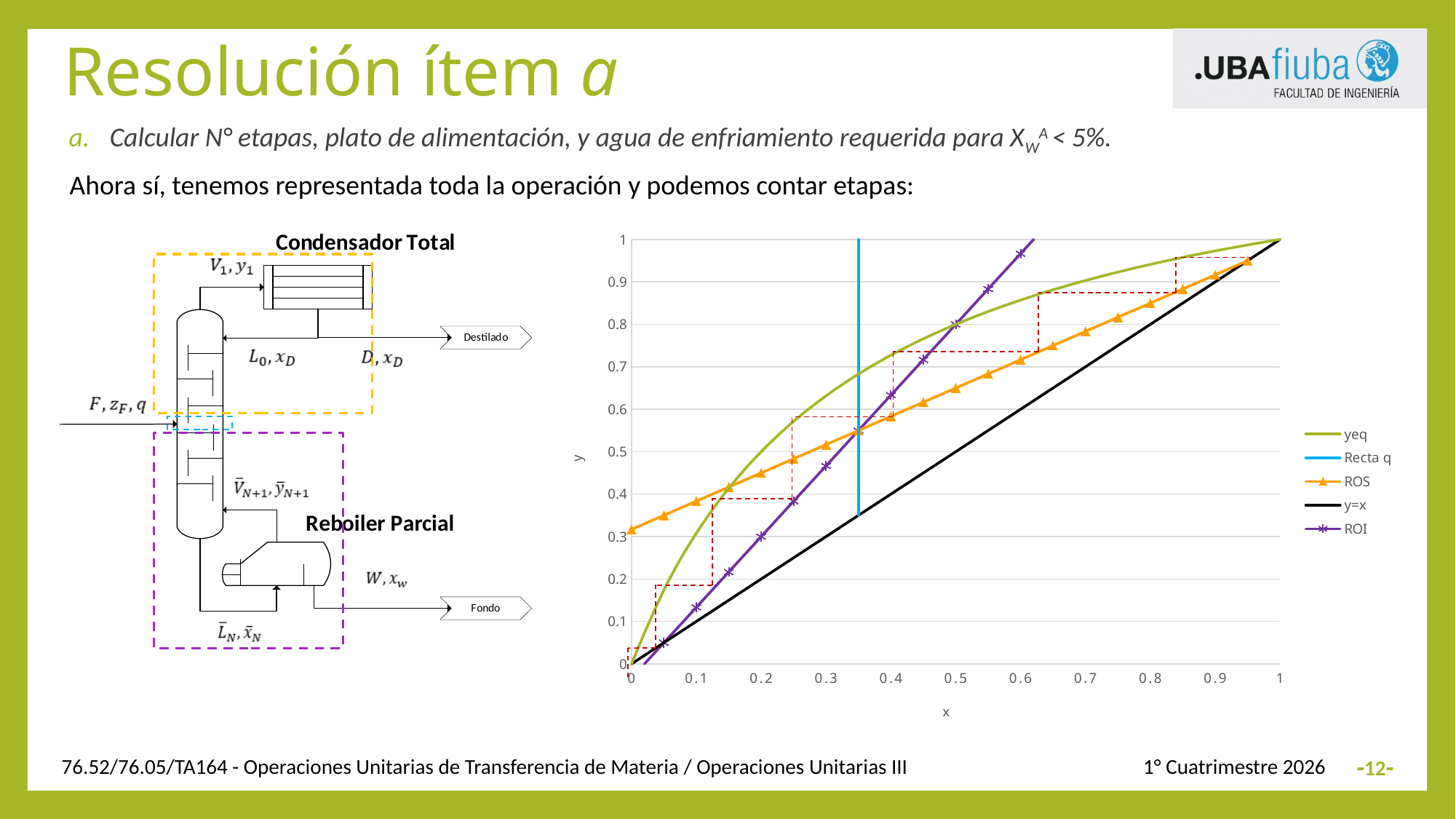
Is the x position of the Recta q line greater or less than 0.3? greater At x = 0.5, which is higher, the ROI line or the y=x line? ROI How many series does the chart legend list? 5 Does the yeq curve rise or fall as x increases? rise Is the value of the ROS line at x = 0 greater or less than 0.2? greater What kind of chart is shown on the right of the slide? line chart What is the value of the y=x line at x = 0.5? 0.5 Is the value of the ROI line at x = 0.5 greater or less than 0.7? greater What label is shown on the horizontal axis of the chart? x Which series in the legend is drawn as a vertical line? Recta q What is the maximum value shown on the x axis of the chart? 1